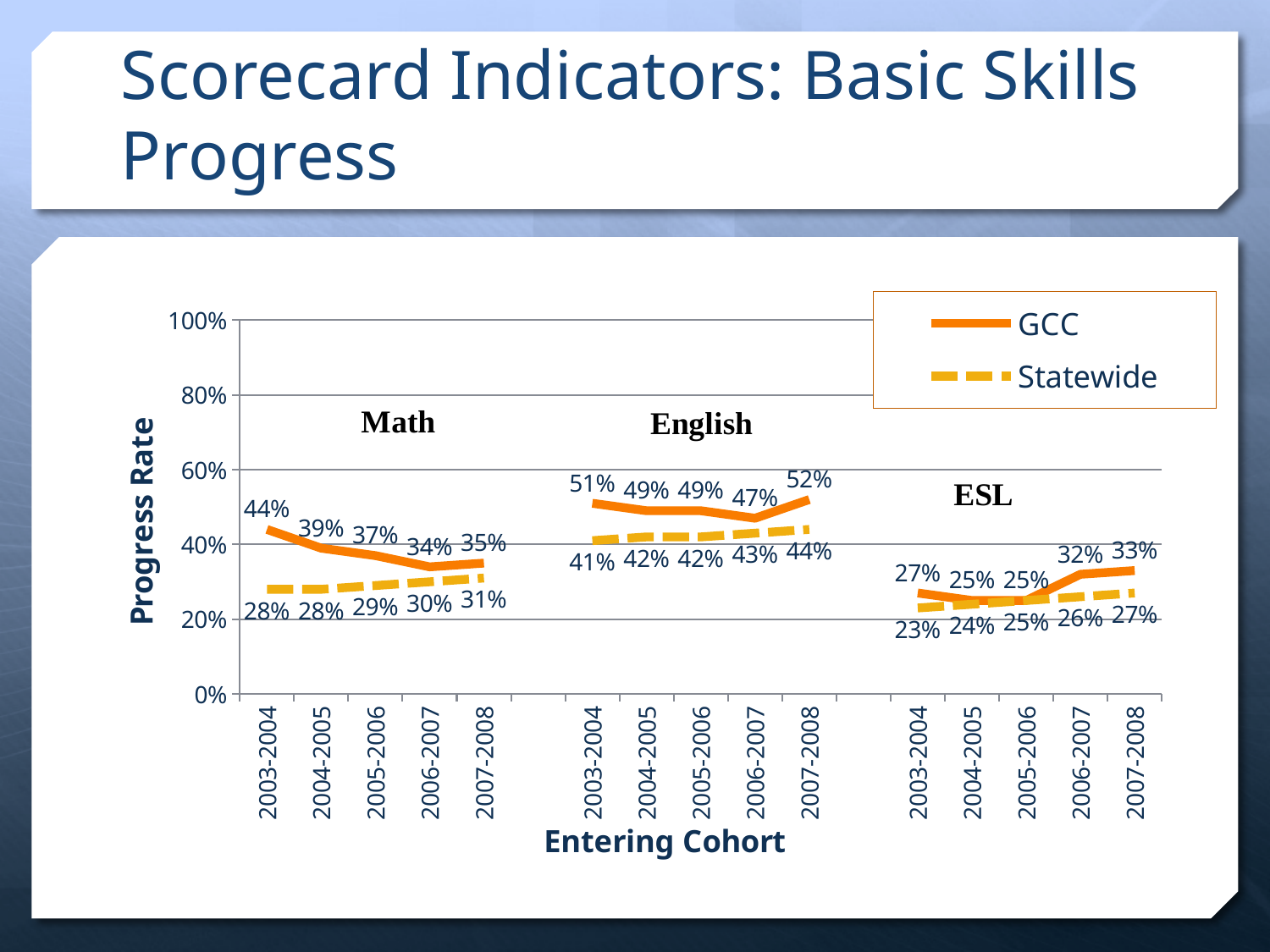
What is the difference between the GCC and Statewide progress rates for the 2003-2004 cohort in Math? 16% How many entering cohorts are plotted for each subject area? 5 Which entering cohort has the lowest GCC progress rate in Math? 2006-2007 What is the label of the y axis? Progress Rate What is the Statewide progress rate for the 2007-2008 entering cohort in English? 44% What is the GCC progress rate for the 2006-2007 entering cohort in ESL? 32% Which entering cohort has the highest GCC progress rate in English? 2007-2008 Does the Statewide progress rate in Math rise or fall from the 2003-2004 cohort to the 2007-2008 cohort? Rise How many series does the legend list? 2 Which is larger for the 2005-2006 cohort in English: the GCC rate or the Statewide rate? GCC What is the GCC progress rate for the 2003-2004 entering cohort in Math? 44% What kind of chart is shown on the slide? Line chart